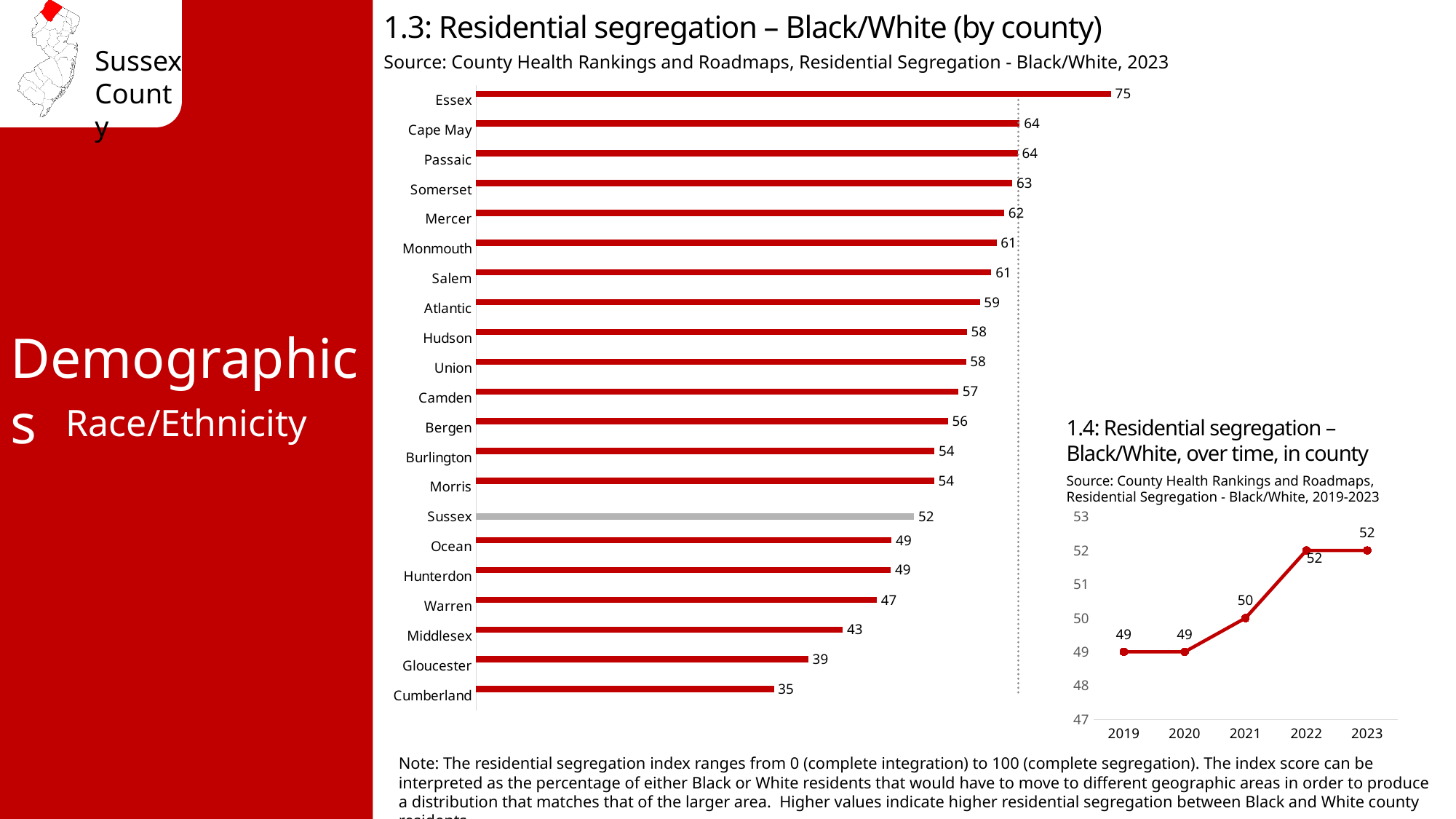
In the chart '1.3: Residential segregation – Black/White (by county)', what is the difference between the values for Essex and Cumberland? 40 In the chart '1.3: Residential segregation – Black/White (by county)', which has a larger value, Morris or Middlesex? Morris In the chart '1.4: Residential segregation – Black/White, over time, in county', do the values rise or fall from 2019 to 2023? Rise In the chart '1.3: Residential segregation – Black/White (by county)', how many counties are shown? 21 In the chart '1.3: Residential segregation – Black/White (by county)', which county has the highest value? Essex In the chart '1.4: Residential segregation – Black/White, over time, in county', what is the value for 2021? 50 In the chart '1.4: Residential segregation – Black/White, over time, in county', how many years are plotted? 5 In the chart '1.3: Residential segregation – Black/White (by county)', what is the value for Gloucester? 39 In the chart '1.3: Residential segregation – Black/White (by county)', what is the value for Sussex? 52 In the chart '1.3: Residential segregation – Black/White (by county)', which county has the lowest value? Cumberland What kind of chart is '1.4: Residential segregation – Black/White, over time, in county'? Line chart What kind of chart is '1.3: Residential segregation – Black/White (by county)'? Bar chart